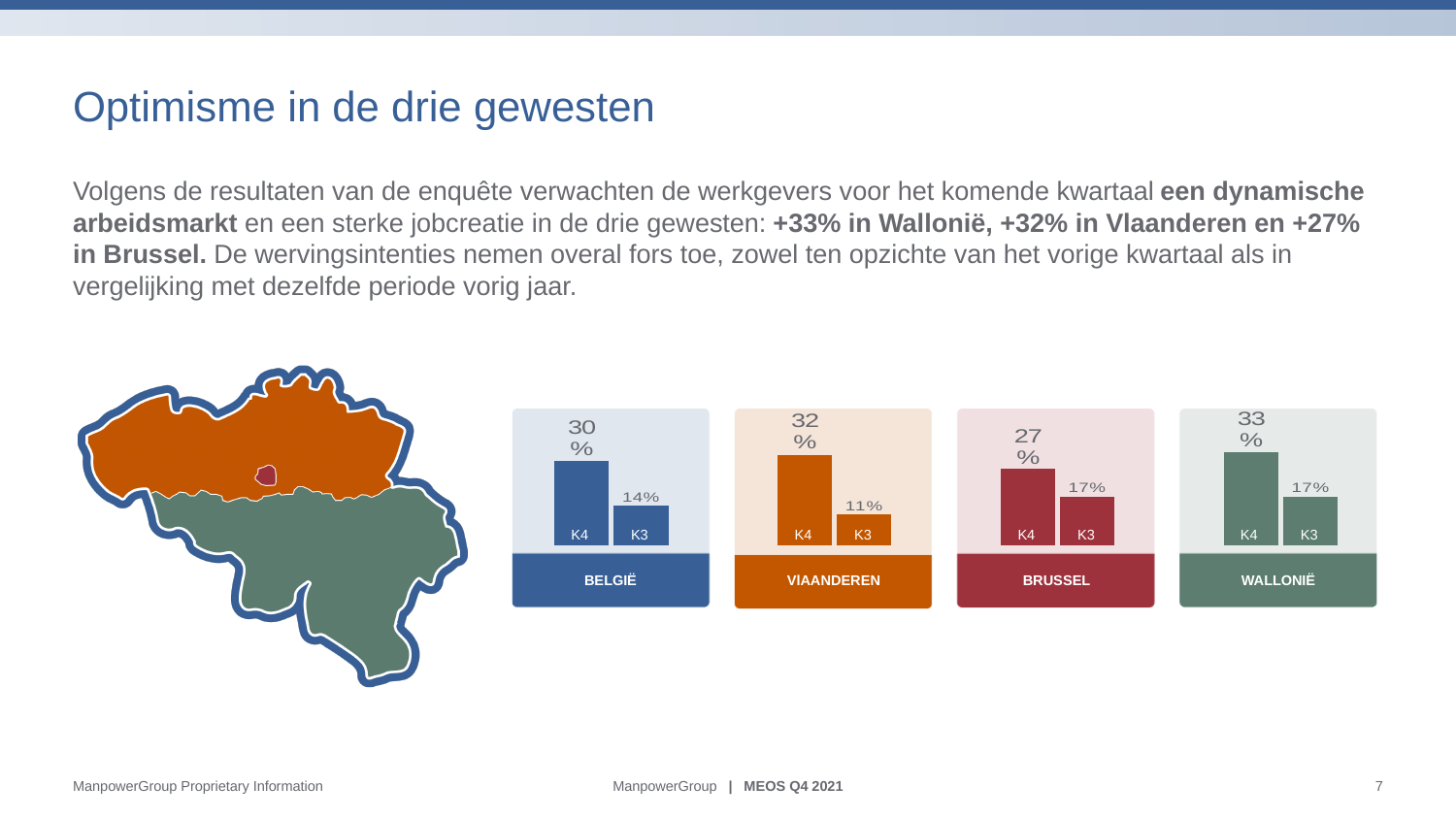
What type of chart is used in the VIAANDEREN panel? Bar chart In the WALLONIË chart, which bar is higher, K4 or K3? K4 In the VIAANDEREN chart, what is the value for K3? 11% In the WALLONIË chart, what is the value for K4? 33% In the BELGIË chart, what is the value for K3? 14% In the BELGIË chart, which category has the lowest value? K3 How many regional bar charts are shown on the slide? 4 In the BELGIË chart, what is the value for K4? 30% In the VIAANDEREN chart, what is the difference between the K4 and K3 values? 21% In the BRUSSEL chart, what is the value for K4? 27% How many bars are shown in the BRUSSEL chart? 2 In the BRUSSEL chart, what is the difference between the K4 and K3 values? 10%